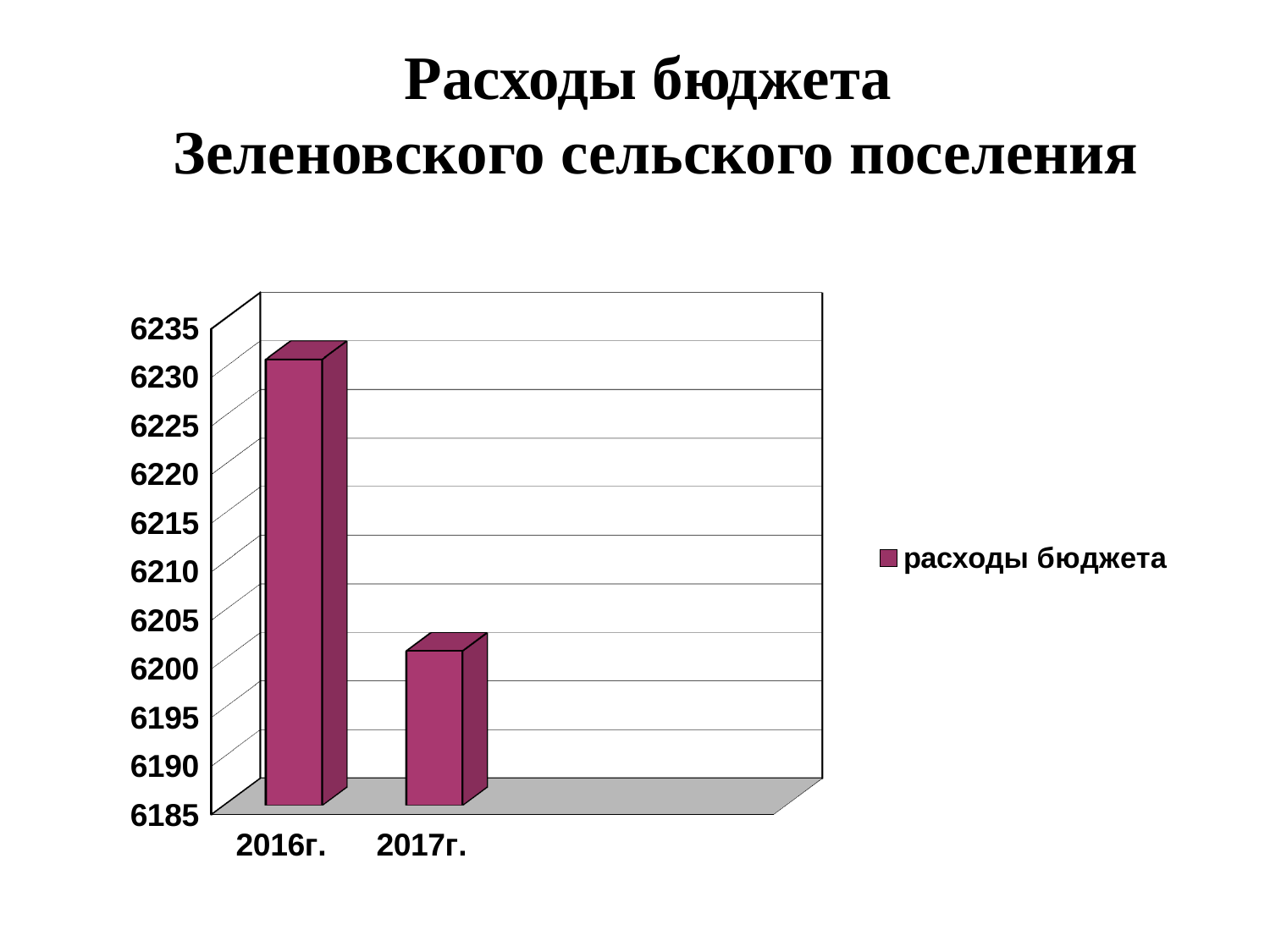
Which year has the higher budget expenditure in the chart? 2016г. Which year has the lower budget expenditure in the chart? 2017г. What is the title of the slide? Расходы бюджета Зеленовского сельского поселения Is the value for 2016г. greater or less than 6225? greater How many categories are shown on the x axis of the chart? 2 Do the values rise or fall from 2016г. to 2017г.? fall What kind of chart is shown on the slide? bar chart Is the value for 2016г. larger or smaller than the value for 2017г.? larger How many series does the chart legend list? 1 What is the name of the series shown in the chart legend? расходы бюджета Is the value for 2017г. greater or less than 6195? greater Is the value for 2017г. greater or less than 6205? less